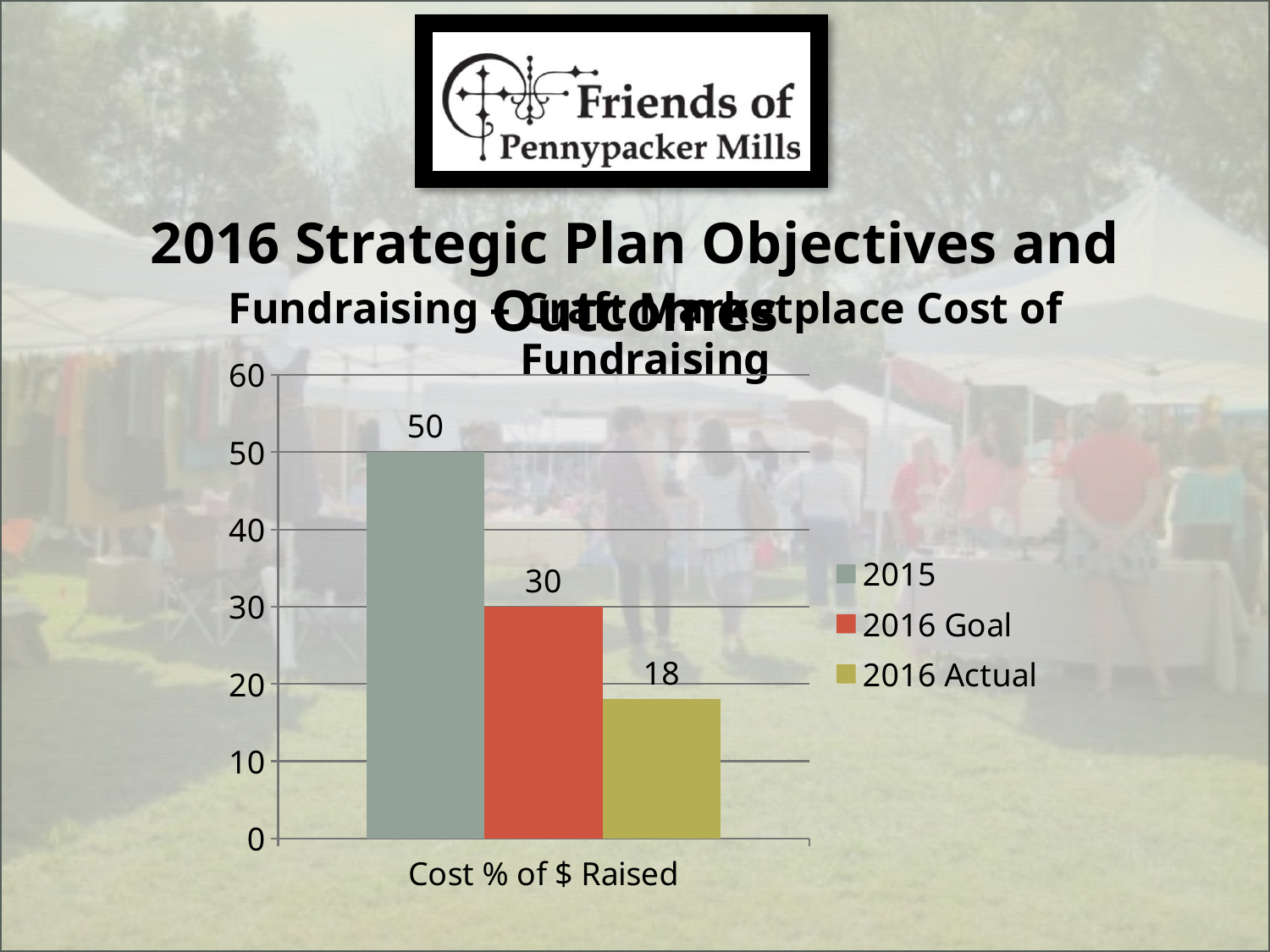
Which series has the highest value? 2015 What kind of chart is shown on the slide? Bar chart Which is larger, the 2016 Goal value or the 2016 Actual value? 2016 Goal Which series has the lowest value? 2016 Actual What is the value for the 2016 Goal series? 30 What is the value for the 2016 Actual series? 18 How many series does the legend list? 3 What is the value for 2015 in the Cost % of $ Raised chart? 50 What is the category label shown on the x axis of the chart? Cost % of $ Raised What is the highest value shown on the chart's y axis? 60 By how much does the 2016 Goal value exceed the 2016 Actual value? 12 What is the difference between the 2015 value and the 2016 Actual value? 32